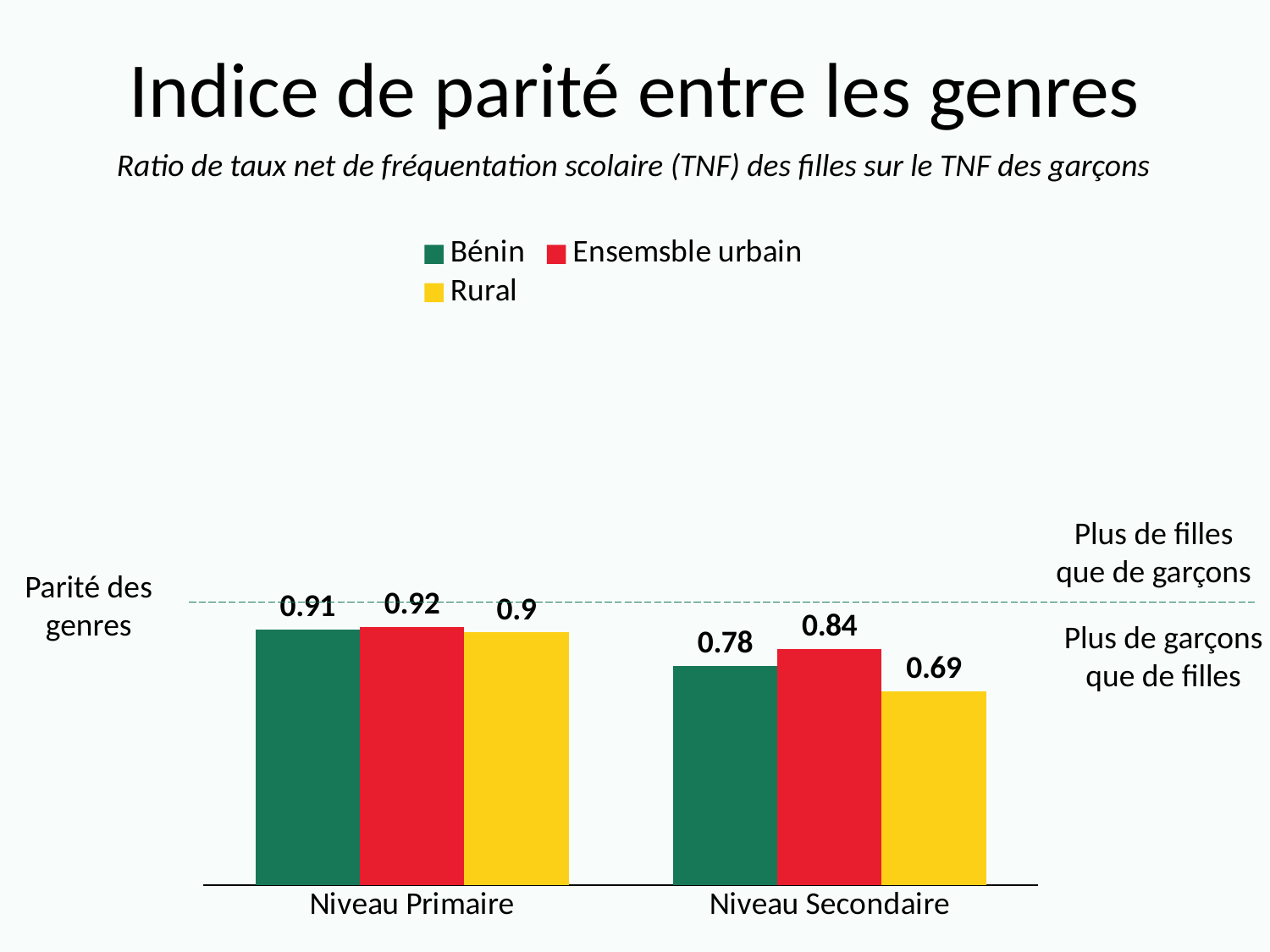
What kind of chart is shown on the slide? Bar chart What is the difference between the Bénin values at Niveau Primaire and Niveau Secondaire? 0.13 Which series has the highest value at Niveau Secondaire? Ensemsble urbain What is the value for Rural at Niveau Secondaire? 0.69 What is the value for Rural at Niveau Primaire? 0.9 Which is larger: the Bénin value at Niveau Secondaire or the Rural value at Niveau Secondaire? Bénin What is the value for Ensemsble urbain at Niveau Secondaire? 0.84 What is the value for Bénin at Niveau Primaire? 0.91 What is the difference between the Ensemsble urbain and Rural values at Niveau Secondaire? 0.15 How many categories are shown on the x axis? 2 How many series does the legend list? 3 Which series has the lowest value at Niveau Secondaire? Rural